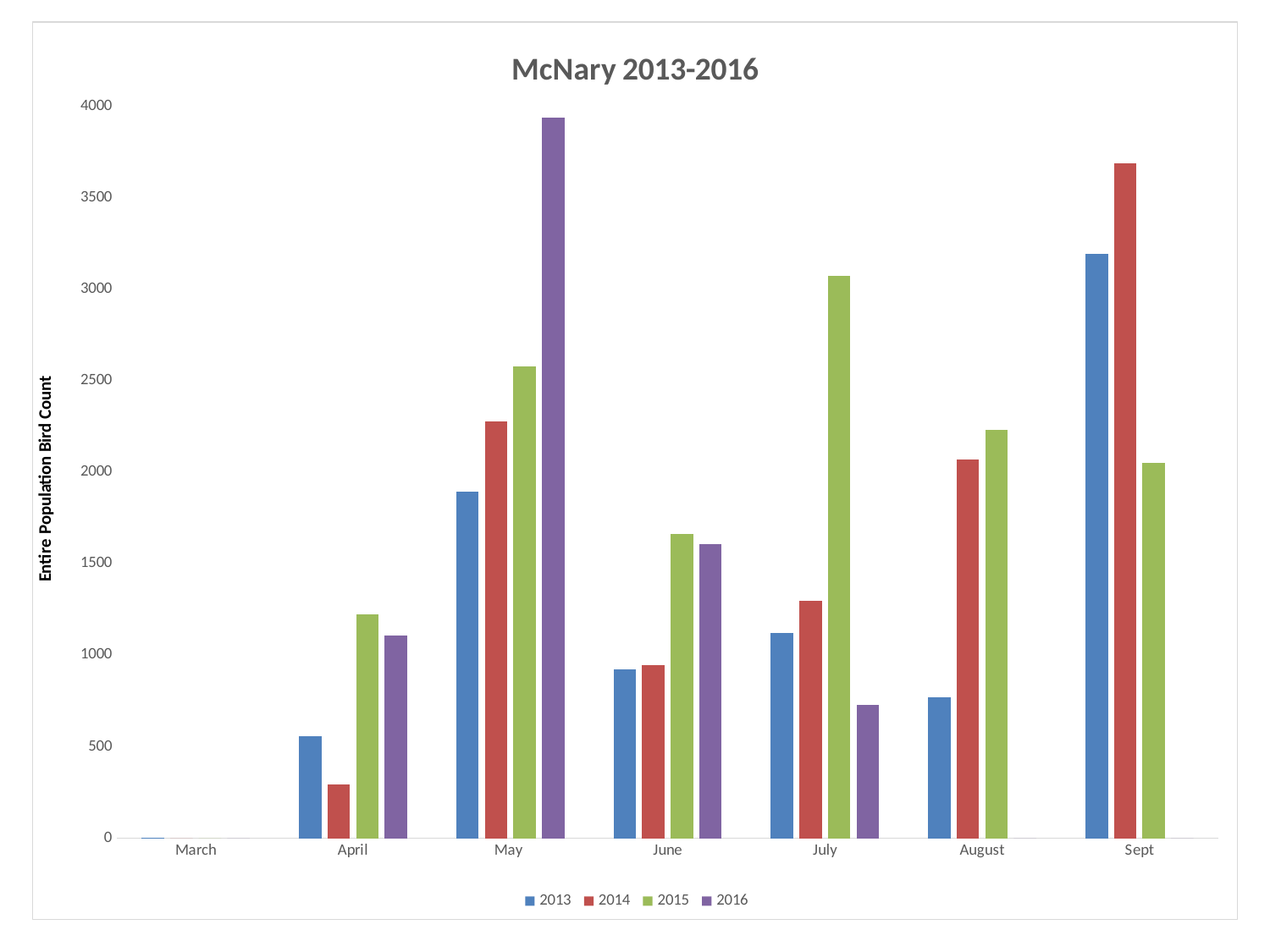
Which is larger in July, the value for 2014 or the value for 2015? 2015 Which series has the lowest bar in April? 2014 What kind of chart is shown on the slide? bar chart Is the value for 2014 in April greater or less than 500? less How many series does the legend list? 4 What is the title of the chart? McNary 2013-2016 How many month categories are shown on the x axis? 7 Which is larger in Sept, the value for 2013 or the value for 2015? 2013 Is the value for 2016 in May greater or less than 3500? greater Which month has the highest bar for the 2016 series? May What is the label of the vertical axis? Entire Population Bird Count